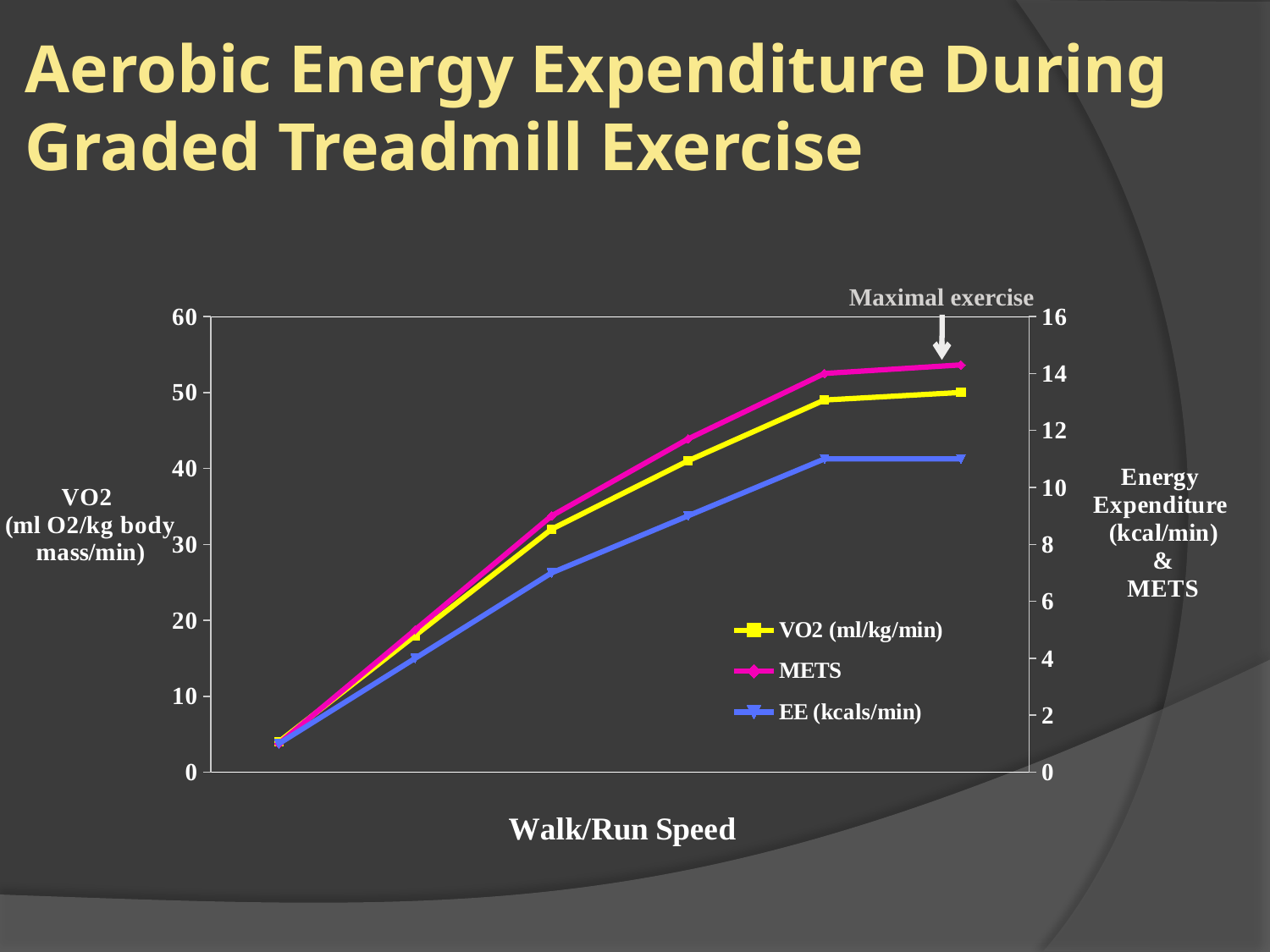
How many series does the legend list? 3 Do the values of the METS series rise or fall as Walk/Run Speed increases along the x axis? rise What kind of chart is shown on the slide? line chart What is the title of the x axis? Walk/Run Speed Is the value of the VO2 (ml/kg/min) series at the second point greater or less than 20 on the left axis? less How many data points are plotted for the VO2 (ml/kg/min) series? 6 Is the value of the VO2 (ml/kg/min) series at the third point greater or less than 30 on the left axis? greater Which is larger for the METS series: the value at the first point or the value at the last point? the last point What label is written above the arrow pointing to the last data points? Maximal exercise Is the value of the EE (kcals/min) series at the last point greater or less than 10 on the right axis? greater Which point of the VO2 (ml/kg/min) series has the lowest value? the first point